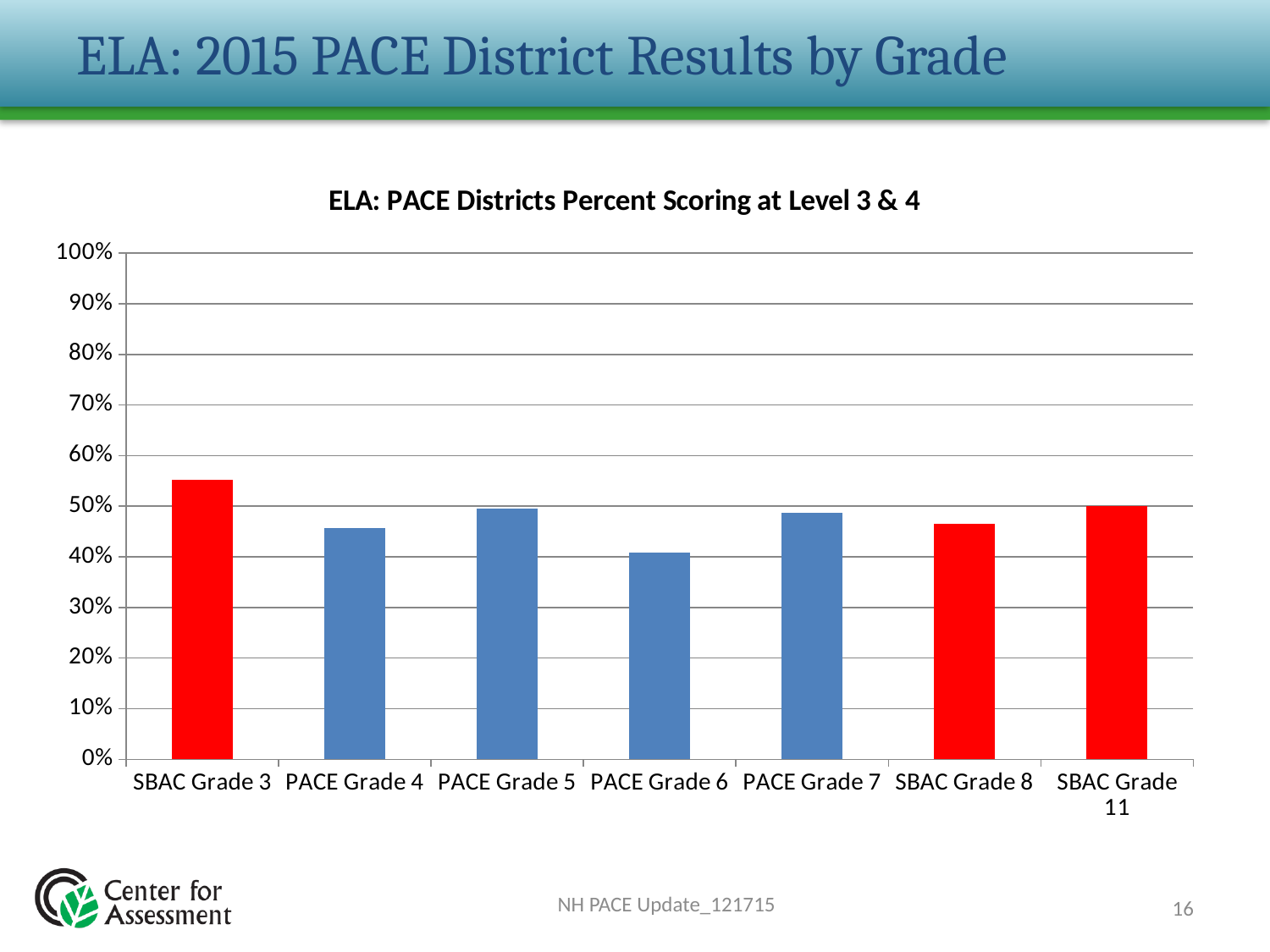
Is the value for SBAC Grade 3 greater or less than 50%? greater Is the value for PACE Grade 6 greater or less than 50%? less How many grade categories are plotted on the chart? 7 What kind of chart is shown on the slide? bar chart Which category has the lowest percent scoring at Level 3 & 4? PACE Grade 6 Is the value for SBAC Grade 8 greater or less than 50%? less Which is larger, the value for PACE Grade 5 or the value for PACE Grade 6? PACE Grade 5 Which category has the highest percent scoring at Level 3 & 4? SBAC Grade 3 What colour are the bars for the SBAC grades? red What is the title of the chart? ELA: PACE Districts Percent Scoring at Level 3 & 4 Which is larger, the value for SBAC Grade 3 or the value for SBAC Grade 8? SBAC Grade 3